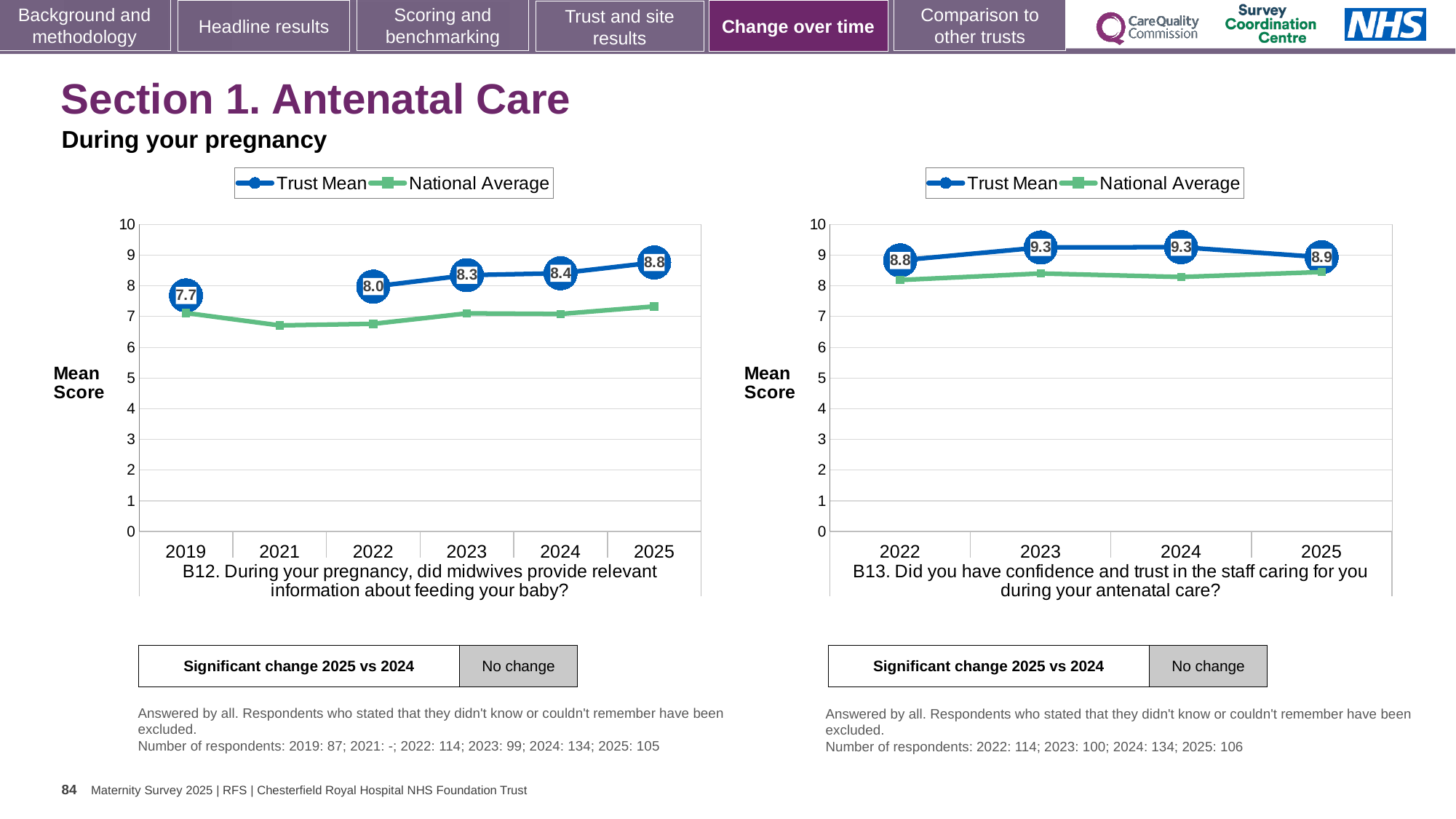
In the B13 chart on the right, what is the Trust Mean for 2022? 8.8 In the B12 chart on the left, which year has the lowest labelled Trust Mean? 2019 In the B13 chart on the right, what is the Trust Mean for 2025? 8.9 In the B12 chart on the left, is the National Average for 2021 greater or less than 7? less In the B12 chart on the left, what is the Trust Mean for 2025? 8.8 How many series does the legend of the B12 chart on the left list? 2 In the B12 chart on the left, what is the Trust Mean for 2019? 7.7 In the B12 chart on the left, what is the difference between the Trust Mean in 2025 and in 2019? 1.1 In the B13 chart on the right, what is the difference between the Trust Mean in 2023 and in 2025? 0.4 How many years are shown on the x axis of the B13 chart on the right? 4 In the B12 chart on the left, which year has the highest Trust Mean? 2025 In the B13 chart on the right, is the Trust Mean for 2022 higher or lower than the Trust Mean for 2023? lower